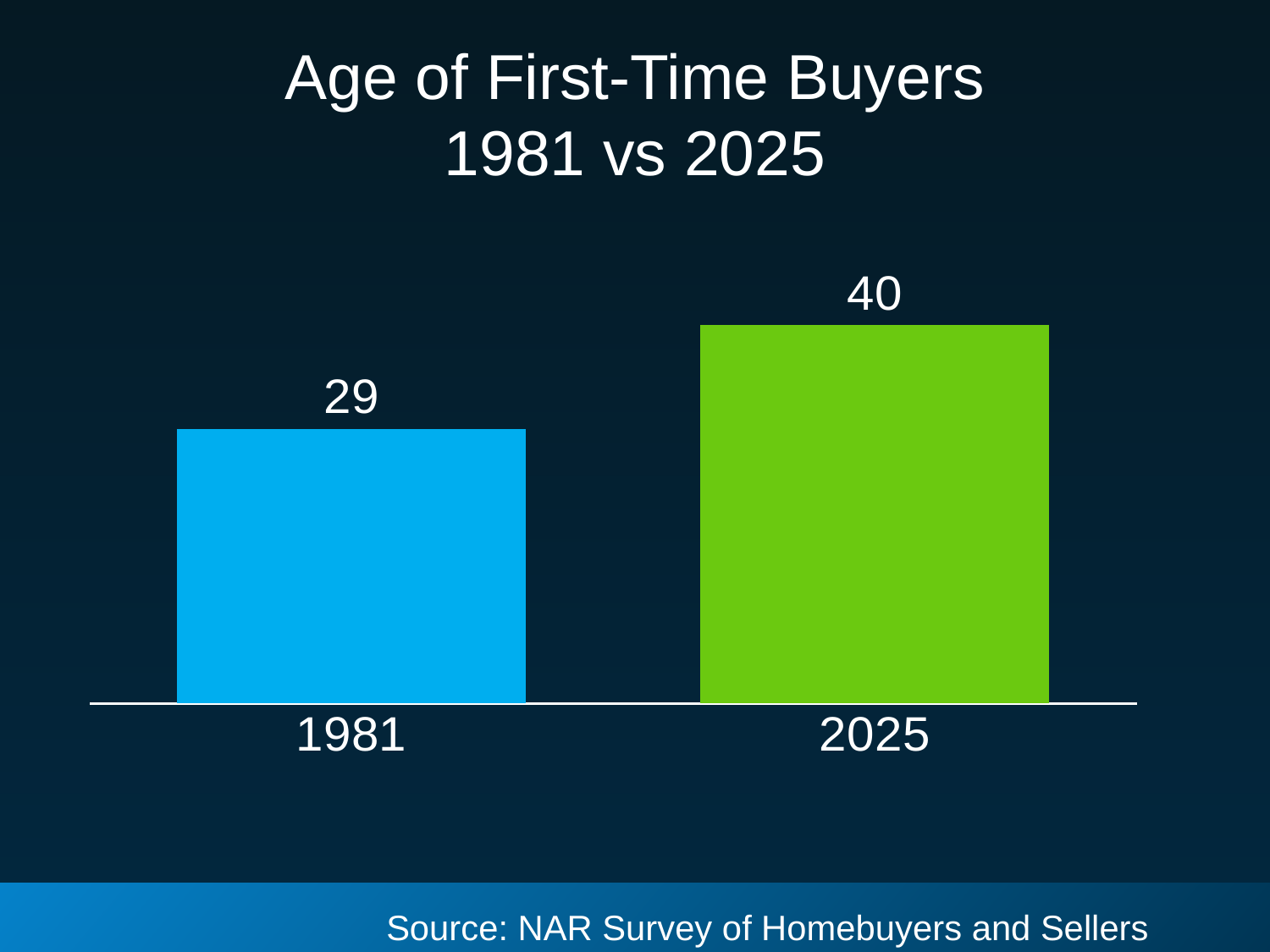
What is the age of first-time buyers shown for 2025? 40 What colour is the bar for 2025? green Is the value for 2025 larger or smaller than the value for 1981? larger Which year has the lower age of first-time buyers? 1981 What is the age of first-time buyers shown for 1981? 29 How many categories are shown on the x axis? 2 Do the values rise or fall from 1981 to 2025? rise What kind of chart is shown on the slide? bar chart What is the title of the chart? Age of First-Time Buyers 1981 vs 2025 Which year has the higher age of first-time buyers? 2025 By how much does the age of first-time buyers in 2025 exceed that in 1981? 11